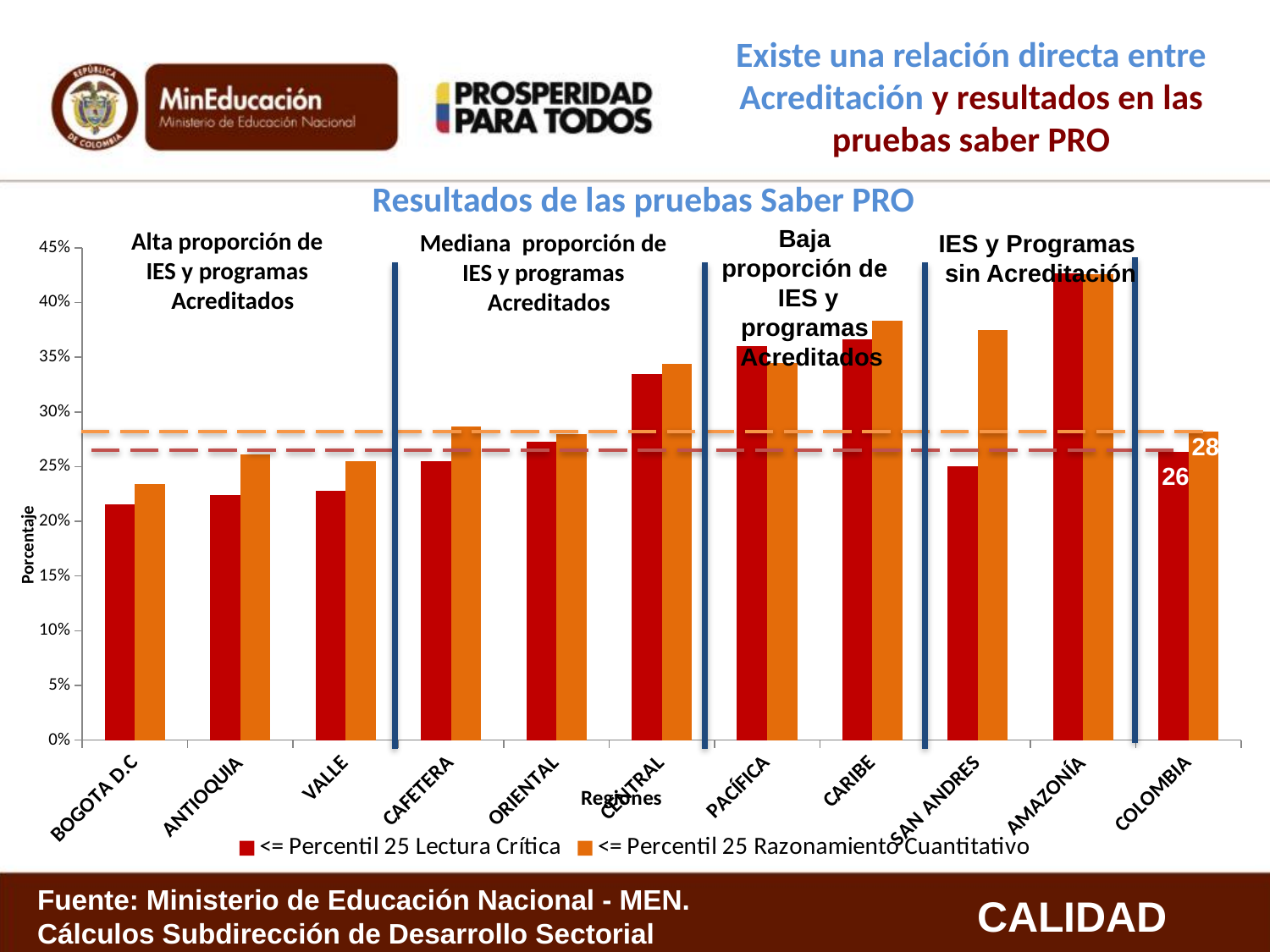
What is the value for COLOMBIA in the '<= Percentil 25 Razonamiento Cuantitativo' series? 28 What is the value for COLOMBIA in the '<= Percentil 25 Lectura Crítica' series? 26 How many series does the legend list? 2 What type of chart is shown on the slide? bar chart For COLOMBIA, what is the difference between the Razonamiento Cuantitativo value and the Lectura Crítica value? 2 Is the '<= Percentil 25 Lectura Crítica' value for AMAZONÍA greater or less than 40%? greater Which region has the lowest '<= Percentil 25 Razonamiento Cuantitativo' value? BOGOTA D.C Which region has the highest '<= Percentil 25 Lectura Crítica' value? AMAZONÍA How many regions (categories) are shown on the x axis? 11 Is the '<= Percentil 25 Razonamiento Cuantitativo' value for SAN ANDRES greater or less than 35%? greater What is the title of the chart? Resultados de las pruebas Saber PRO For SAN ANDRES, which series has the larger value: Lectura Crítica or Razonamiento Cuantitativo? Razonamiento Cuantitativo